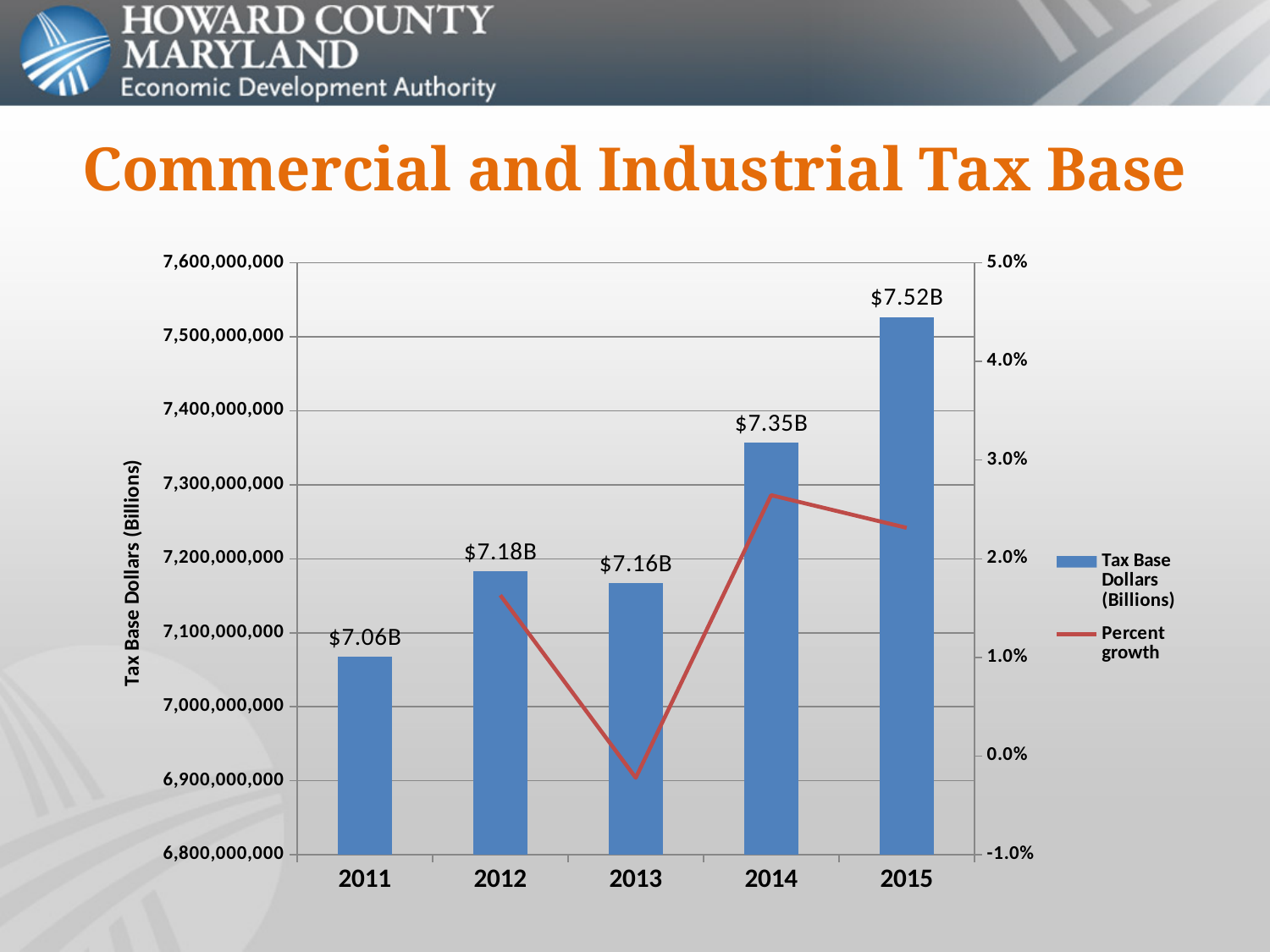
What is the difference between the tax base values for 2015 and 2011? $0.46B What is the title of the chart? Commercial and Industrial Tax Base What is the tax base value shown for 2015? $7.52B What is the tax base value shown for 2013? $7.16B Which year has the highest tax base dollars? 2015 How many years are shown on the x axis? 5 What is the tax base value shown for 2011? $7.06B Is the percent growth value for 2013 greater or less than 0.0%? less How many series does the legend list? 2 Is the percent growth value for 2014 greater or less than 2.0%? greater Which year has the larger tax base, 2012 or 2013? 2012 Which year has the lowest tax base dollars? 2011